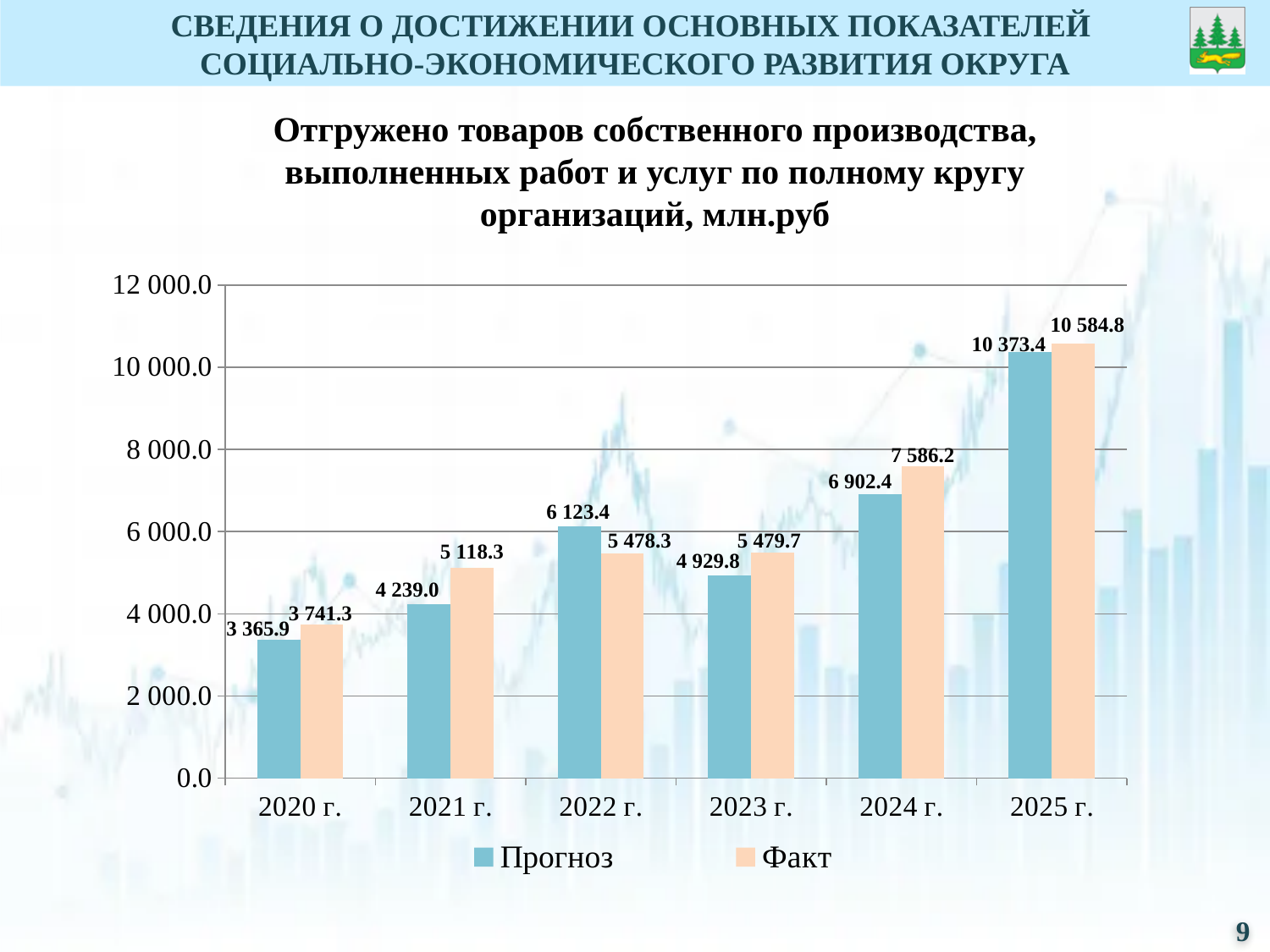
What kind of chart is shown on the slide? bar chart What is the difference between the Прогноз and Факт values for 2022 г.? 645.1 What is the difference between the Факт and Прогноз values for 2025 г.? 211.4 How many series does the legend list? 2 Which year has the highest Факт value? 2025 г. Is the Прогноз value for 2024 г. greater or less than 6 000.0? greater Which year has the lowest Прогноз value? 2020 г. What is the Прогноз value for 2022 г.? 6 123.4 What is the Факт value for 2020 г.? 3 741.3 Which is larger for 2023 г., the Прогноз value or the Факт value? Факт How many years are shown on the x axis? 6 What is the Факт value for 2024 г.? 7 586.2